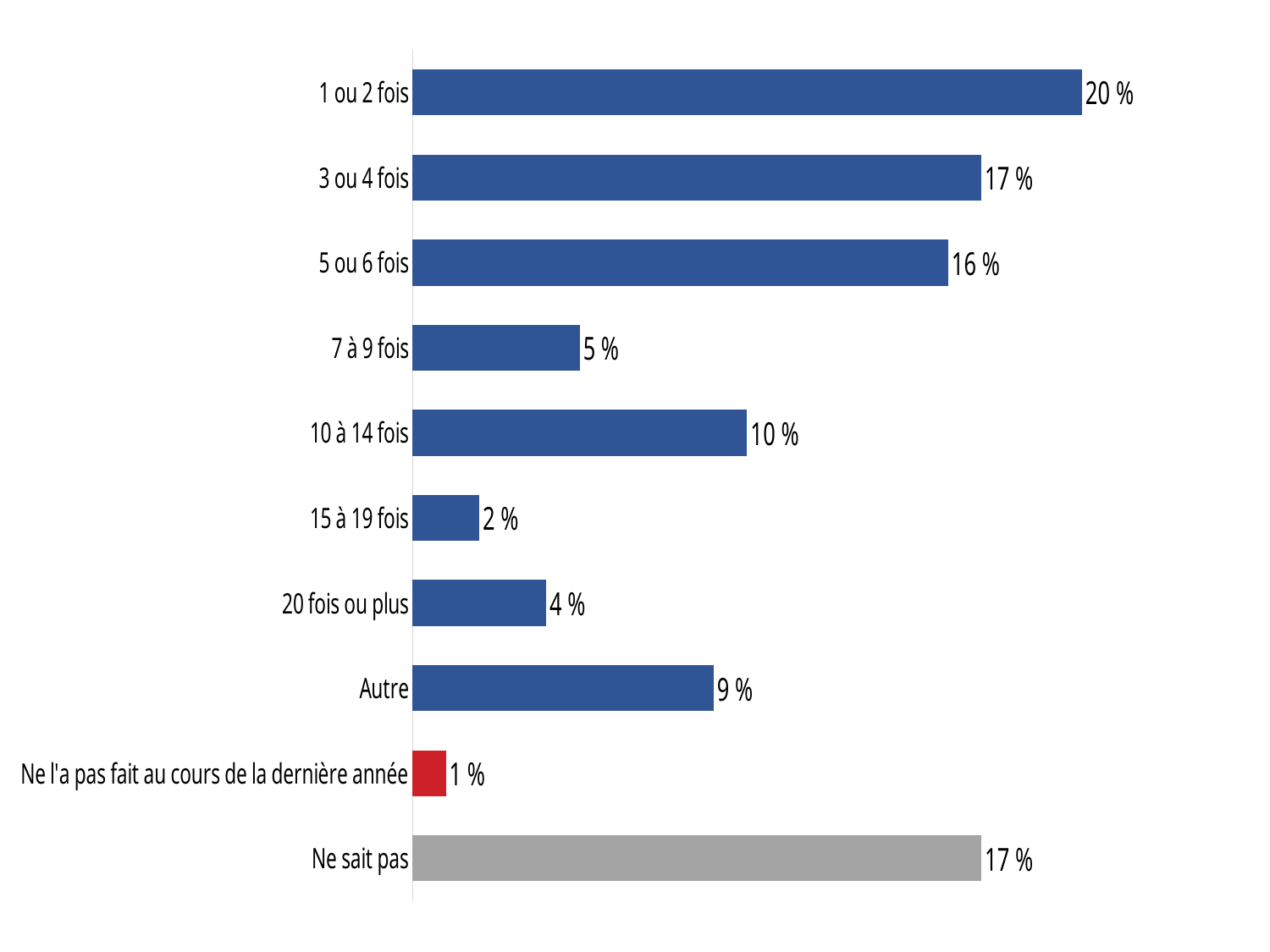
What kind of chart is shown on the slide? Bar chart What is the value for "Ne l'a pas fait au cours de la dernière année"? 1 % Which category has the lowest value? Ne l'a pas fait au cours de la dernière année What colour is the bar for "Ne sait pas"? Grey Which category's bar is red? Ne l'a pas fait au cours de la dernière année What is the value for "Ne sait pas"? 17 % What is the difference between the values for "3 ou 4 fois" and "7 à 9 fois"? 12 % Which is larger, the value for "Autre" or the value for "20 fois ou plus"? Autre Which category has the highest value? 1 ou 2 fois How many categories are shown in the chart? 10 What is the value for "10 à 14 fois"? 10 % What is the value for "1 ou 2 fois"? 20 %